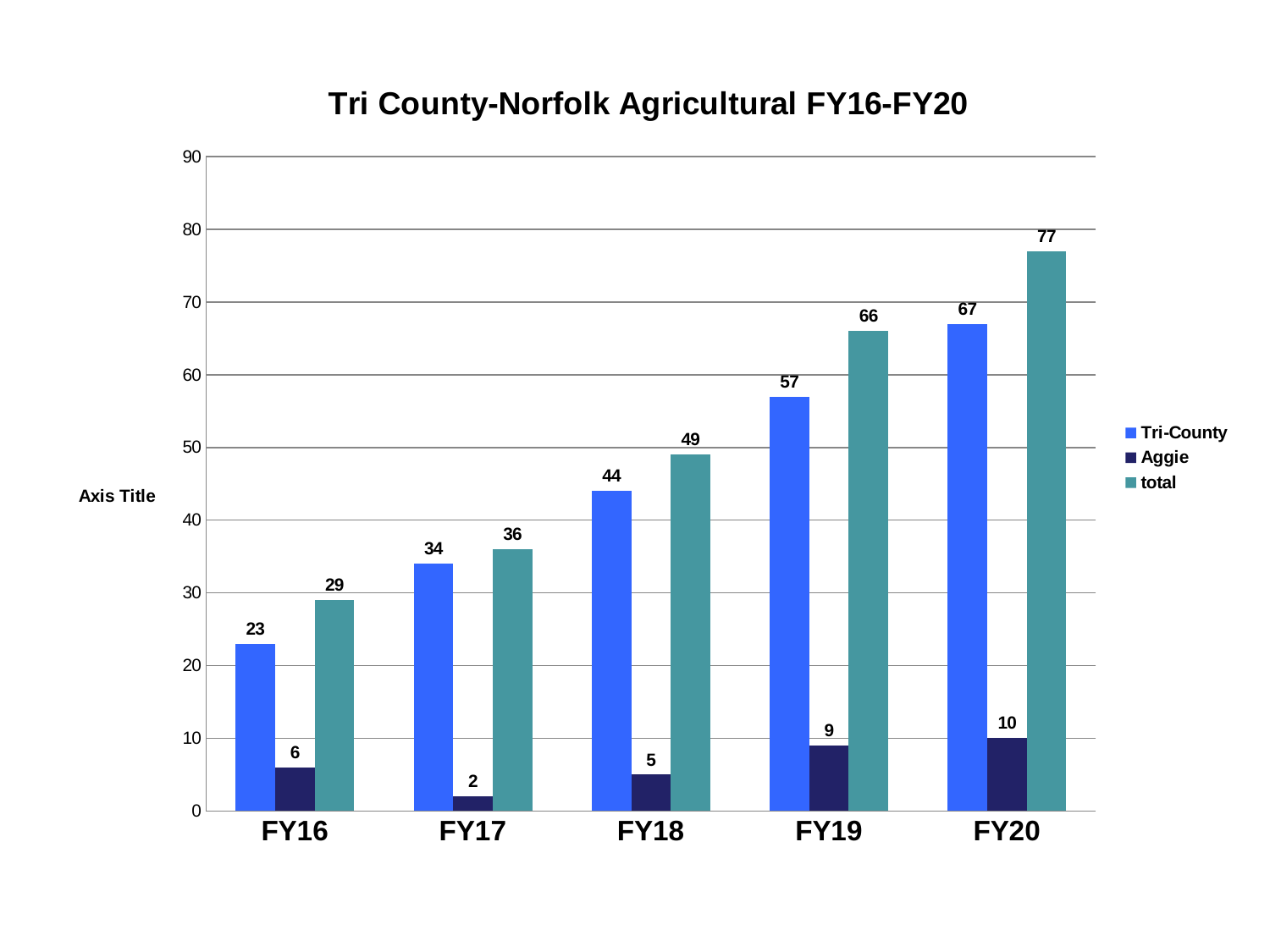
What is the total value for FY20? 77 How many series does the legend list? 3 Do the total values rise or fall from FY16 to FY20? Rise How many fiscal years are shown on the x axis? 5 What is the Aggie value for FY17? 2 Which fiscal year has the lowest Aggie value? FY17 What is the Tri-County value for FY18? 44 What is the title of the chart? Tri County-Norfolk Agricultural FY16-FY20 Which fiscal year has the highest total value? FY20 Which is larger, the Aggie value for FY19 or the Aggie value for FY18? FY19 What is the difference between the Tri-County values for FY20 and FY16? 44 What kind of chart is shown on the slide? Bar chart